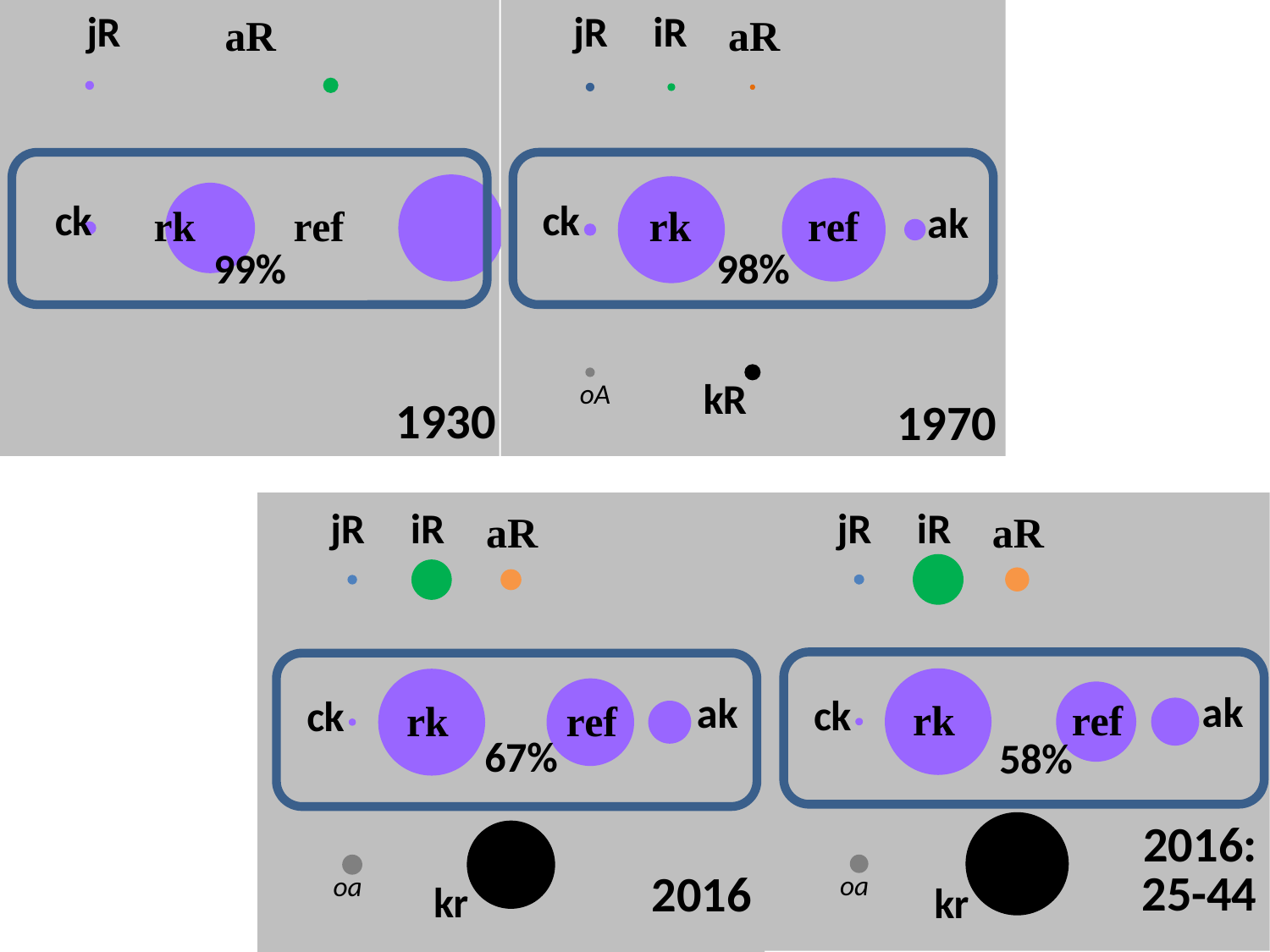
Which panel shows the lowest percentage for the boxed group? 2016: 25-44 In the 1970 panel, what percentage is printed inside the boxed group? 98% In the 1930 panel, what percentage is printed inside the boxed group? 99% What is the difference between the boxed-group percentage in the 2016 panel and the '2016: 25-44' panel? 9 percentage points What kind of chart is used in each panel? bubble chart Is the boxed-group percentage larger in the 1970 panel or in the 2016 panel? 1970 In the '2016: 25-44' panel, what percentage is printed inside the boxed group? 58% How many year panels are shown on the slide? 4 What is the difference between the boxed-group percentage in 1930 and in 2016? 32 percentage points Does the boxed-group percentage rise or fall from 1930 to 1970 to 2016? fall In the 2016 panel, what percentage is printed inside the boxed group? 67% Which panel shows the highest percentage for the boxed group? 1930